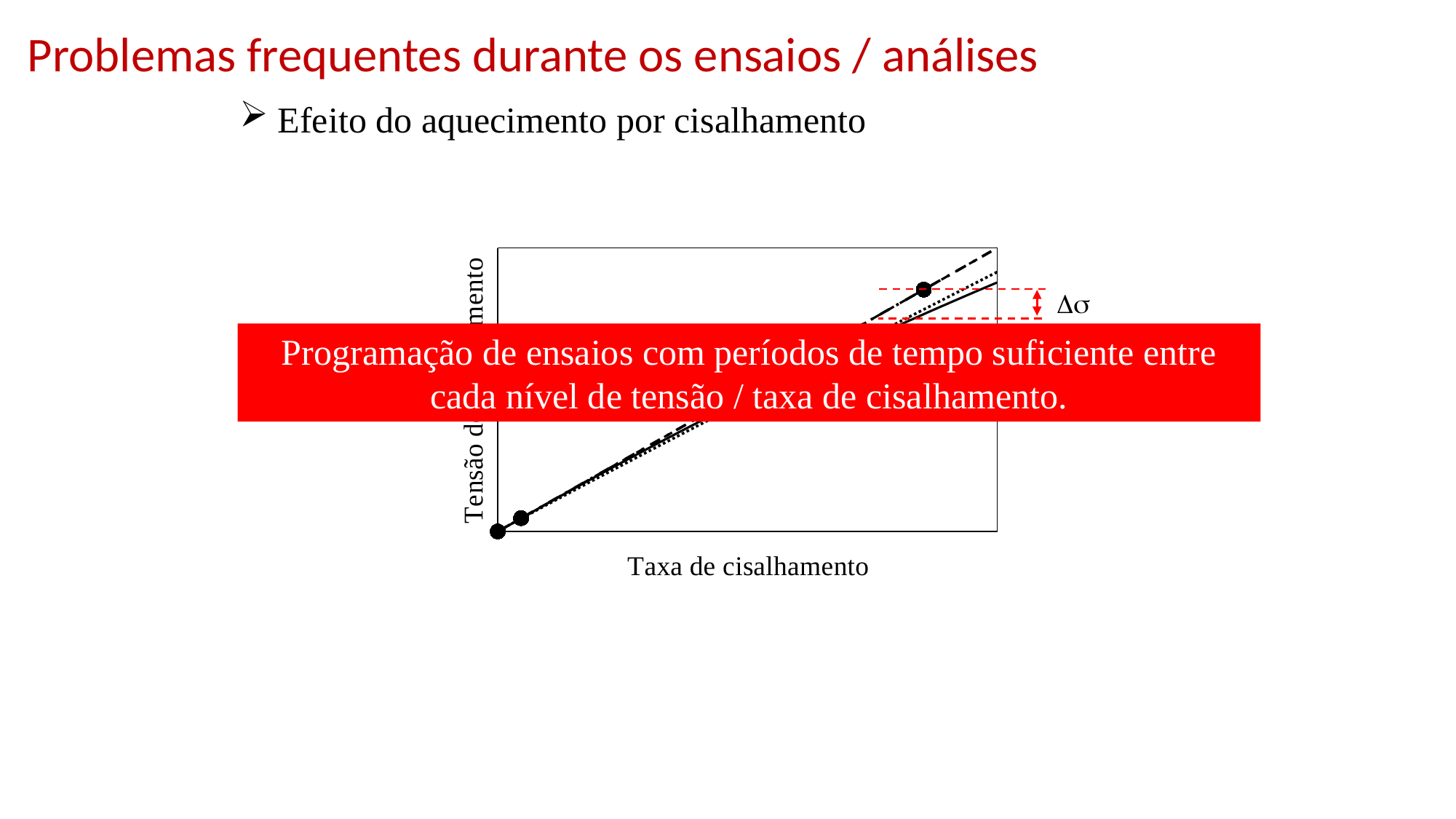
How many black dot markers are plotted on the chart? 3 What is the label of the x axis of the chart? Taxa de cisalhamento Do the plotted lines rise or fall as the shear rate (Taxa de cisalhamento) increases along the x axis? rise What kind of chart is shown on the slide? line chart What symbol labels the red double-headed arrow to the right of the chart? Δσ